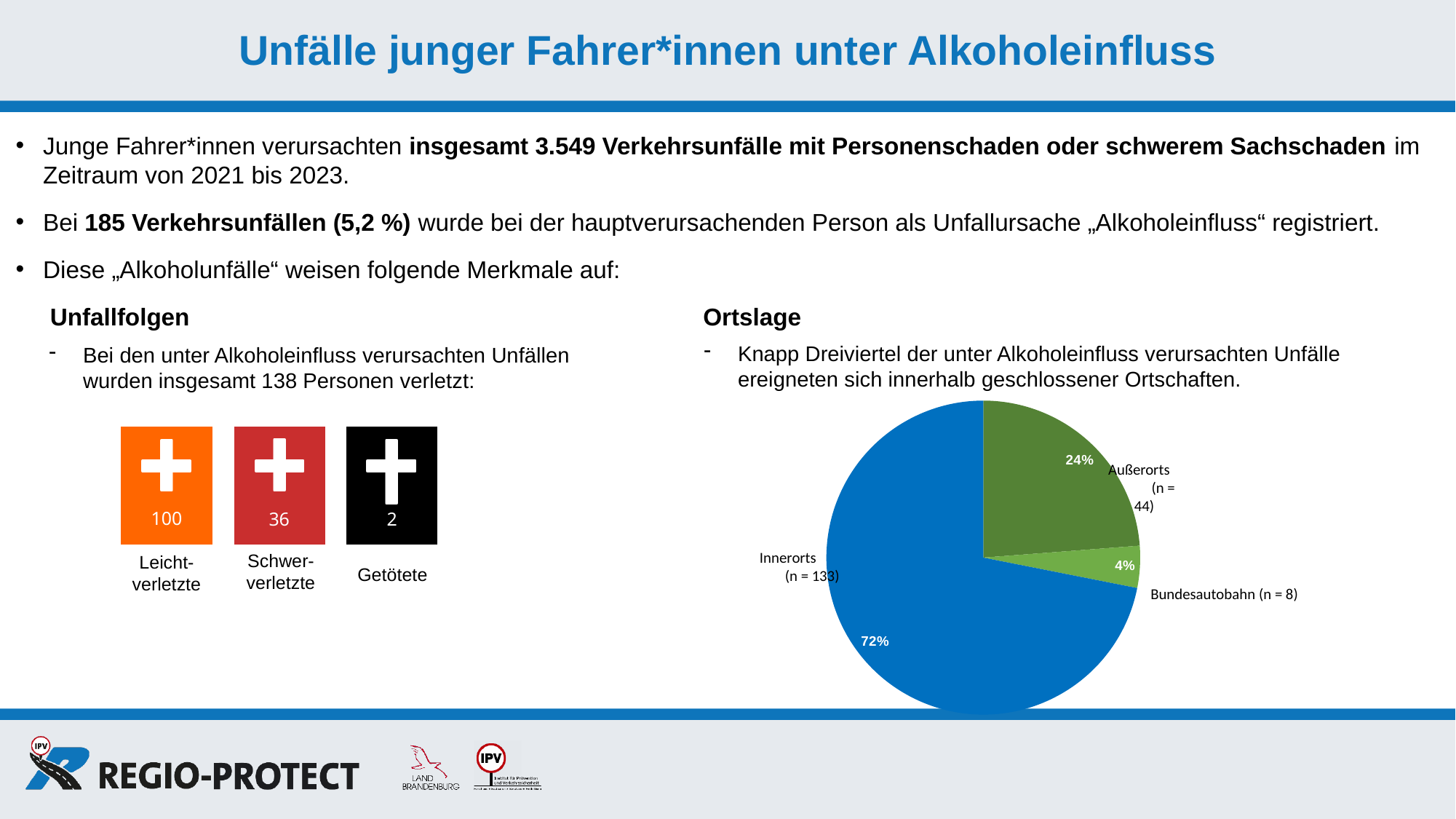
Which slice of the pie chart is the largest? Innerorts In the pie chart, which slice is larger: Außerorts or Bundesautobahn? Außerorts Which slice of the pie chart is the smallest? Bundesautobahn In the pie chart, what percentage share does Außerorts have? 24% In the pie chart, what is the difference in percentage points between Innerorts and Außerorts? 48 How many slices does the pie chart have? 3 In the pie chart, what is the n value given for Innerorts? 133 In the pie chart, what is the n value given for Außerorts? 44 In the pie chart, what percentage share does Bundesautobahn have? 4% In the pie chart, what is the n value given for Bundesautobahn? 8 What kind of chart is shown under the heading "Ortslage"? pie chart In the pie chart, what percentage share does Innerorts have? 72%